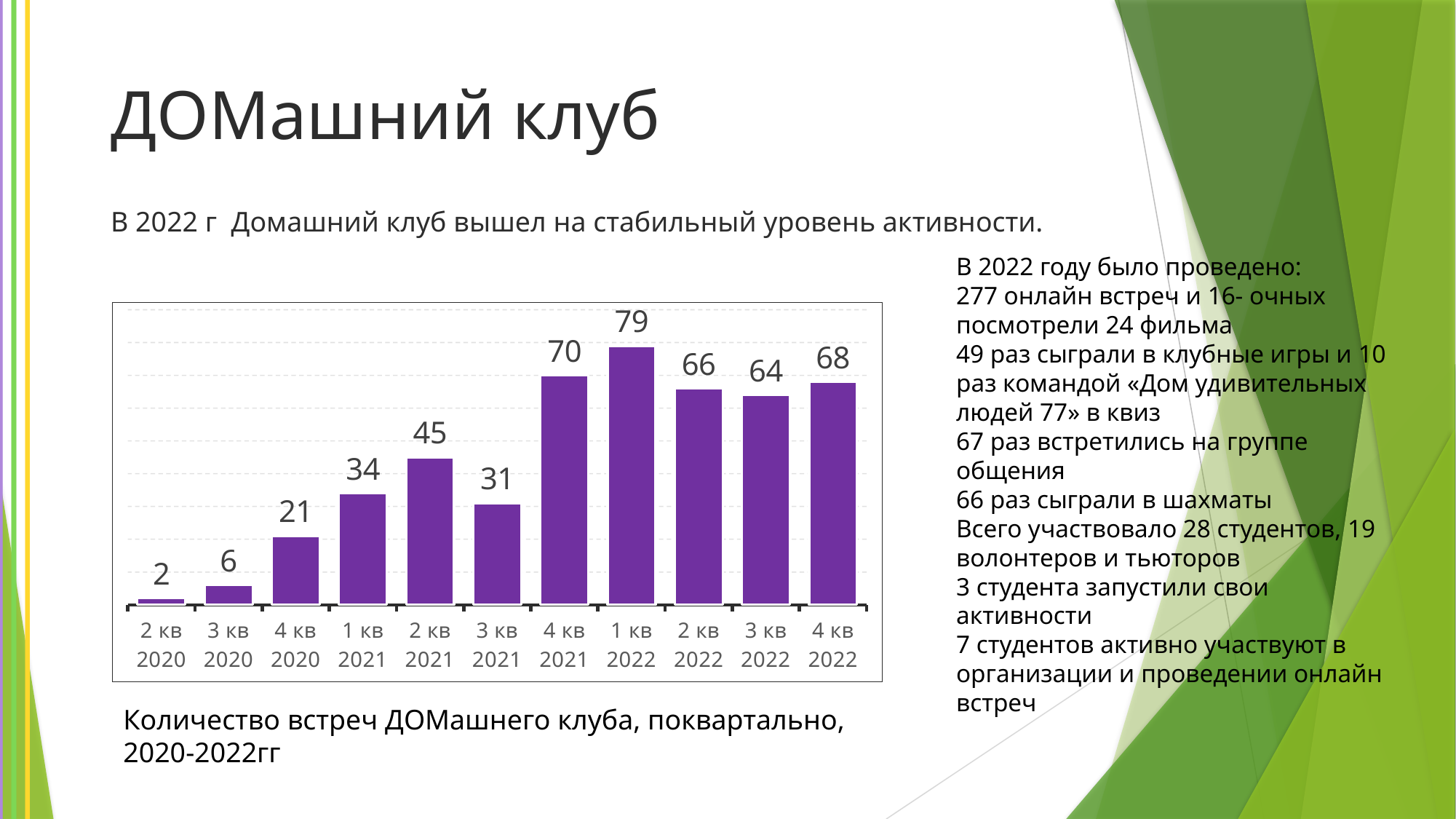
What is the difference between the values for 1 кв 2022 and 4 кв 2021? 9 What is the difference between the values for 2 кв 2021 and 3 кв 2021? 14 What is the value for 1 кв 2022? 79 Which quarter has the lowest value? 2 кв 2020 Which quarter has the highest value? 1 кв 2022 What is the value for 4 кв 2020? 21 What is the value for 3 кв 2021? 31 How many quarters are shown on the x axis? 11 Which is larger, the value for 2 кв 2022 or the value for 3 кв 2022? 2 кв 2022 Do the values generally rise or fall from 2 кв 2020 to 1 кв 2022? rise What colour are the bars in the chart? purple What kind of chart is shown on the slide? bar chart